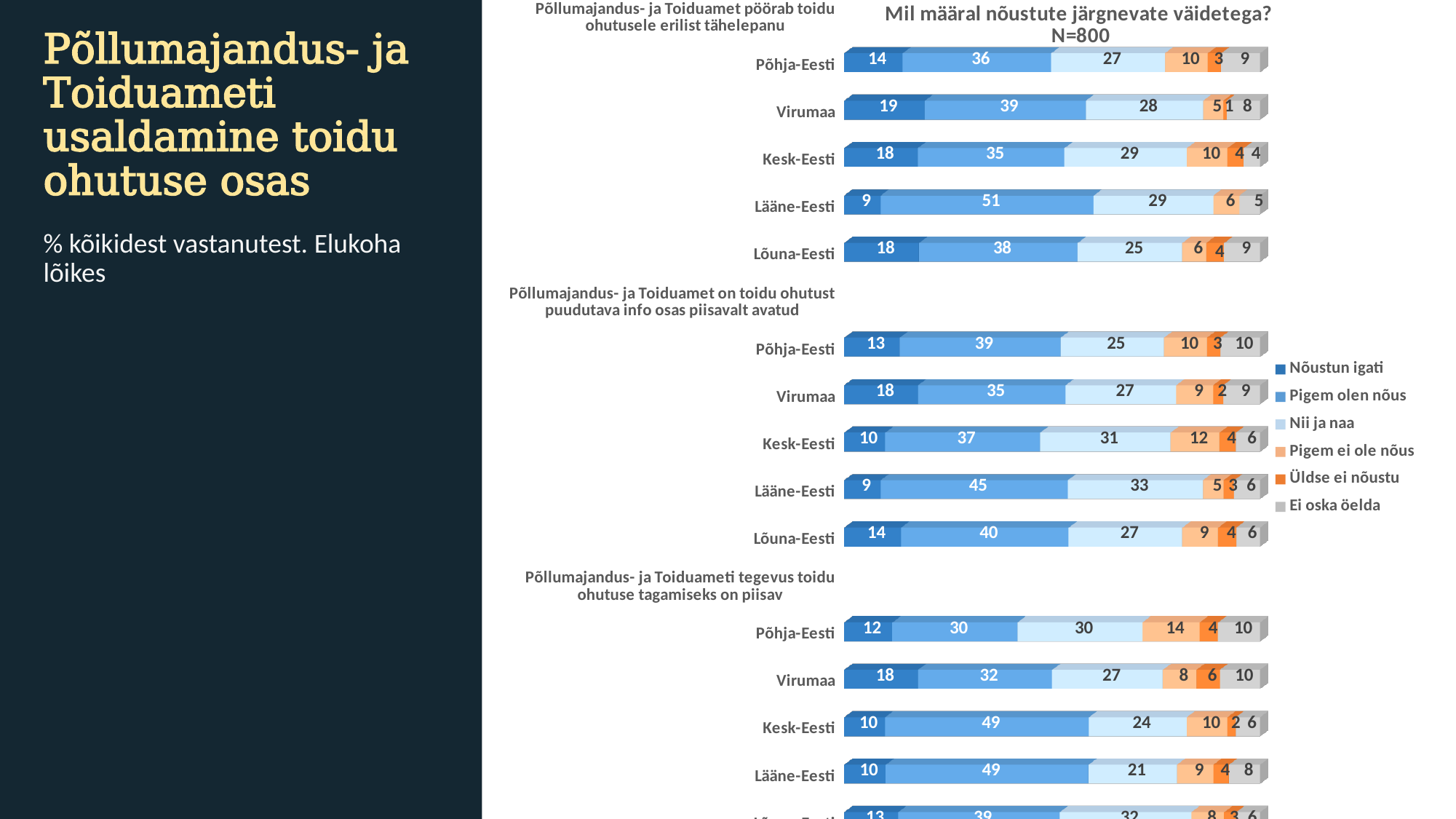
How many series does the legend list? 6 What kind of chart is shown on the slide? Stacked bar chart For the statement 'Põllumajandus- ja Toiduamet on toidu ohutust puudutava info osas piisavalt avatud', which is larger: the 'Nõustun igati' value for Virumaa or for Lääne-Eesti? Virumaa For the statement 'Põllumajandus- ja Toiduamet pöörab toidu ohutusele erilist tähelepanu', what is the total of all labelled segments for Põhja-Eesti? 99 For the statement 'Põllumajandus- ja Toiduamet pöörab toidu ohutusele erilist tähelepanu', what is the 'Pigem olen nõus' value for Lääne-Eesti? 51 For the statement 'Põllumajandus- ja Toiduameti tegevus toidu ohutuse tagamiseks on piisav', what is the difference between the 'Pigem olen nõus' values for Kesk-Eesti and Põhja-Eesti? 19 What sample size (N) is stated in the chart title? N=800 For the statement 'Põllumajandus- ja Toiduamet pöörab toidu ohutusele erilist tähelepanu', which region has the lowest 'Nõustun igati' value? Lääne-Eesti For the statement 'Põllumajandus- ja Toiduamet pöörab toidu ohutusele erilist tähelepanu', which region has the highest 'Pigem olen nõus' value? Lääne-Eesti For the statement 'Põllumajandus- ja Toiduamet on toidu ohutust puudutava info osas piisavalt avatud', what is the 'Nii ja naa' value for Kesk-Eesti? 31 For the statement 'Põllumajandus- ja Toiduameti tegevus toidu ohutuse tagamiseks on piisav', what is the 'Pigem ei ole nõus' value for Põhja-Eesti? 14 How many regions are shown for each statement in the chart? 5